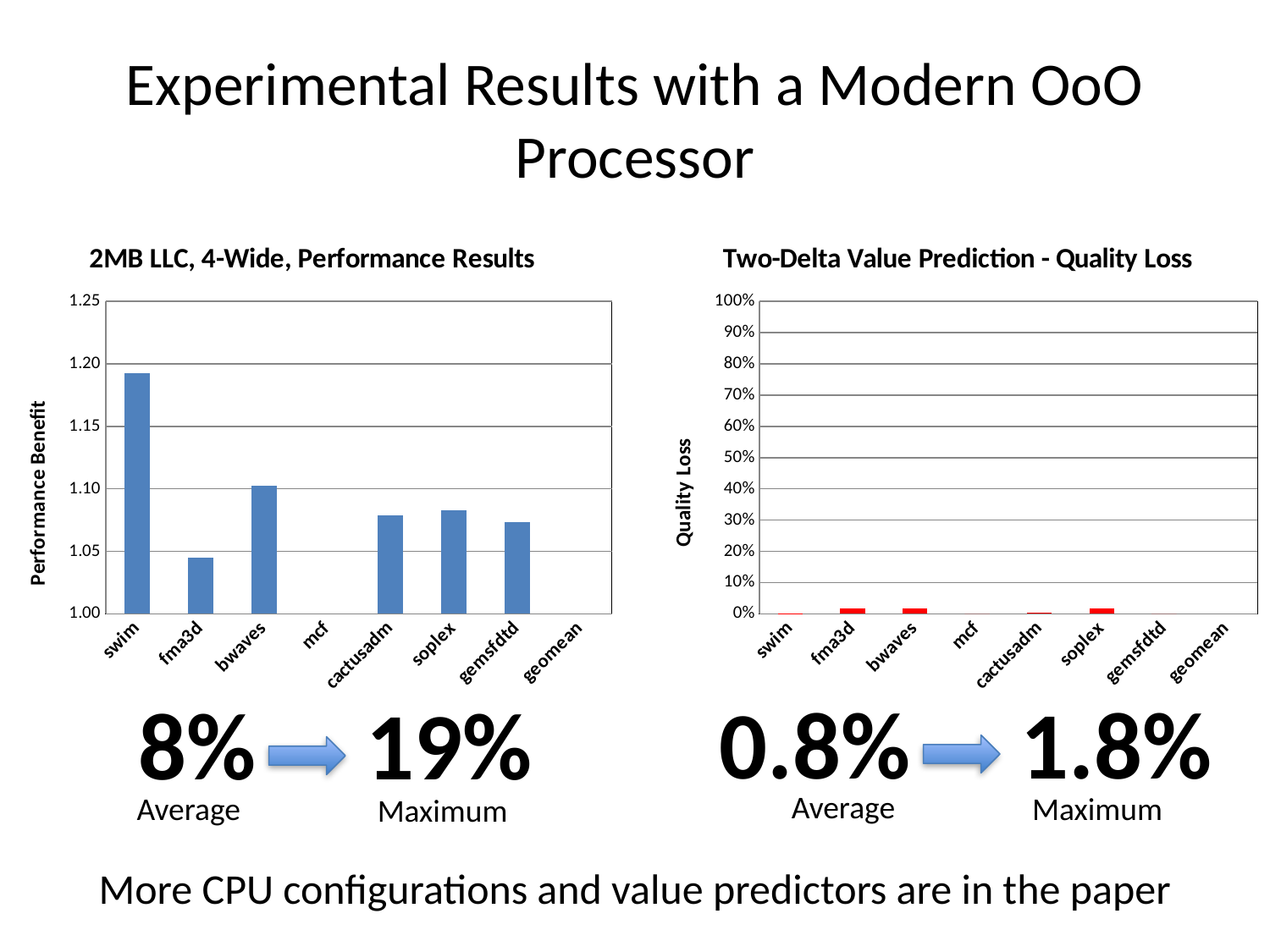
In the '2MB LLC, 4-Wide, Performance Results' chart, which benchmark has the highest performance benefit? swim In the '2MB LLC, 4-Wide, Performance Results' chart, how many categories are shown on the x axis? 8 What kind of chart is the '2MB LLC, 4-Wide, Performance Results' chart? bar chart In the 'Two-Delta Value Prediction - Quality Loss' chart, is the value for fma3d greater or less than 10%? less What kind of chart is the 'Two-Delta Value Prediction - Quality Loss' chart? bar chart In the '2MB LLC, 4-Wide, Performance Results' chart, is the value for swim greater or less than 1.15? greater In the '2MB LLC, 4-Wide, Performance Results' chart, is the value for gemsfdtd greater or less than 1.10? less What is the y-axis title of the '2MB LLC, 4-Wide, Performance Results' chart? Performance Benefit In the '2MB LLC, 4-Wide, Performance Results' chart, which is larger, the value for swim or the value for fma3d? swim What colour are the bars in the 'Two-Delta Value Prediction - Quality Loss' chart? red In the '2MB LLC, 4-Wide, Performance Results' chart, which is larger, the value for bwaves or the value for gemsfdtd? bwaves